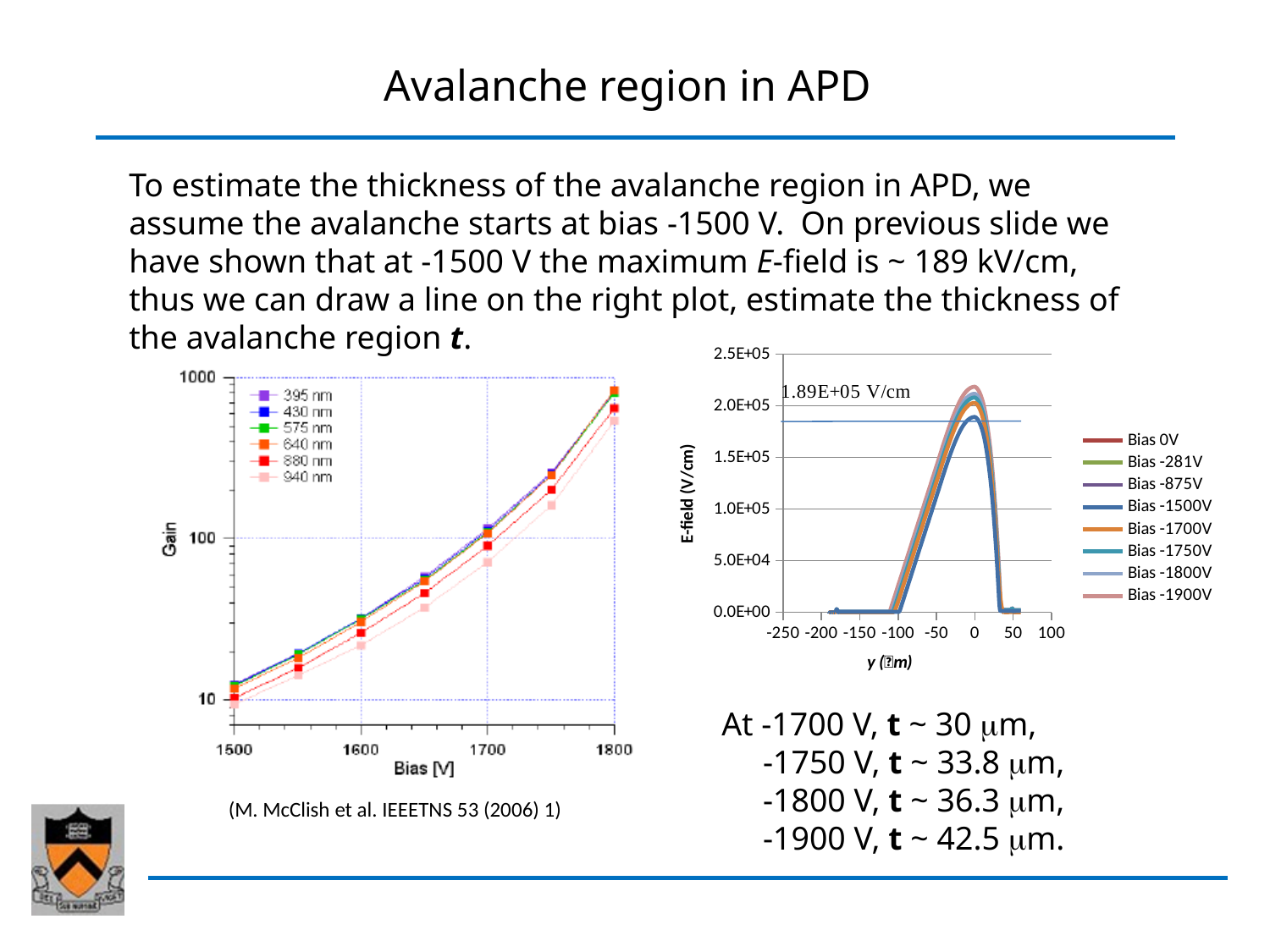
How many series does the legend of the right chart (E-field vs y) list? 8 On the right chart (E-field vs y), which series reaches the highest peak E-field? Bias -1900V What is the label on the x axis of the left chart (Gain vs Bias)? Bias [V] On the left chart (Gain vs Bias), which has the larger gain at 1700 V: 395 nm or 940 nm? 395 nm On the left chart (Gain vs Bias), is the gain for 395 nm at 1800 V greater or less than 100? greater On the left chart (Gain vs Bias), is the gain for 940 nm at 1500 V greater or less than 100? less What kind of chart is the left chart (Gain vs Bias)? line chart On the left chart (Gain vs Bias), does the gain rise or fall as the bias increases from 1500 V to 1800 V? rise On the right chart (E-field vs y), what E-field value is the horizontal line labelled with? 1.89E+05 V/cm How many series does the legend of the left chart (Gain vs Bias) list? 6 On the left chart (Gain vs Bias), which series has the lowest gain at 1700 V? 940 nm On the right chart (E-field vs y), is the peak E-field for Bias -1900V greater or less than 2.0E+05? greater